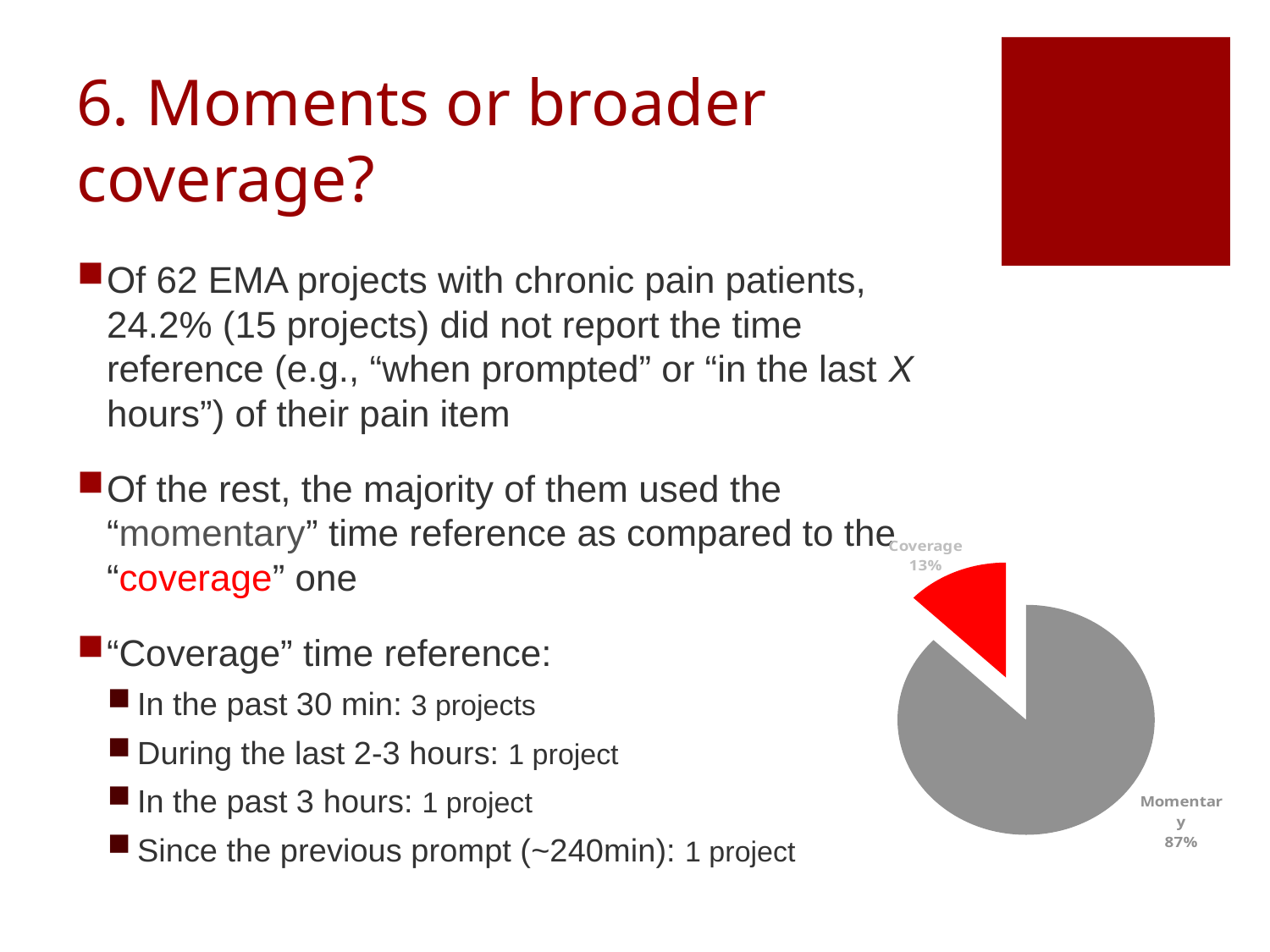
How many slices does the pie chart have? 2 What colour is the "Coverage" slice in the pie chart? red Which slice of the pie chart is the smallest? Coverage Which is larger in the pie chart, "Coverage" or "Momentary"? Momentary Which slice of the pie chart is the largest? Momentary What is the difference in percentage points between the "Momentary" and "Coverage" slices? 74 What share of the pie does the "Momentary" slice represent? 87% What colour is the "Momentary" slice in the pie chart? gray What do the two slices of the pie chart add up to? 100% What kind of chart is shown on the slide? pie chart What share of the pie does the "Coverage" slice represent? 13%